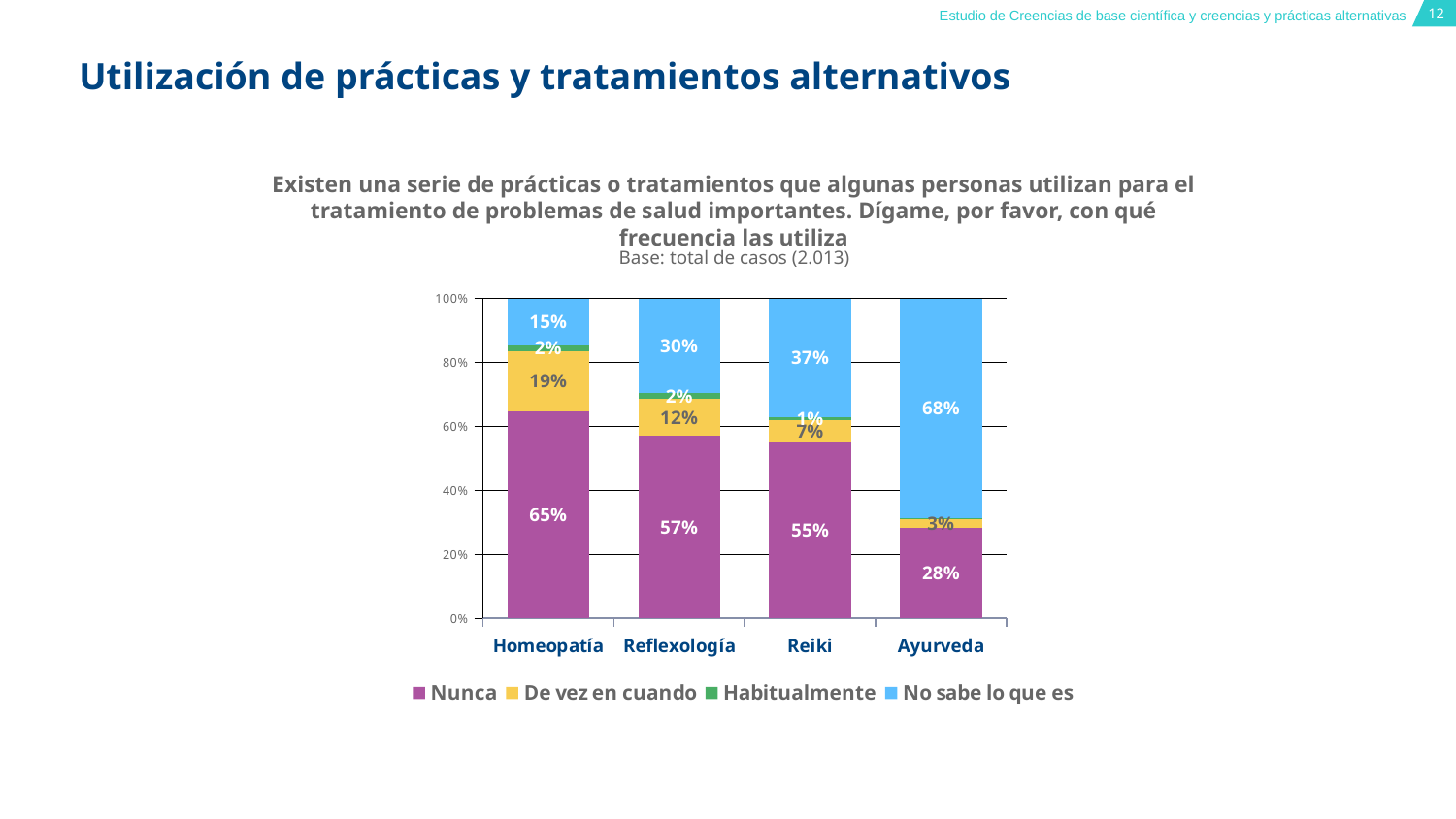
What percentage of respondents answered "Nunca" for Homeopatía? 65% How many percentage points higher is the "Nunca" value for Homeopatía than for Reflexología? 8 percentage points Does the "Nunca" value rise or fall from Homeopatía to Ayurveda along the x axis? Fall Which practice has the highest "Nunca" percentage? Homeopatía What kind of chart is shown on the slide? Stacked bar chart How many practices are shown on the x axis of the chart? 4 How many series does the chart legend list? 4 Which practice has the lowest "Nunca" percentage? Ayurveda What is the "De vez en cuando" value for Reflexología? 12% Which has a larger "No sabe lo que es" value, Reiki or Reflexología? Reiki What percentage of respondents answered "No sabe lo que es" for Ayurveda? 68% What is the "Habitualmente" value for Reiki? 1%